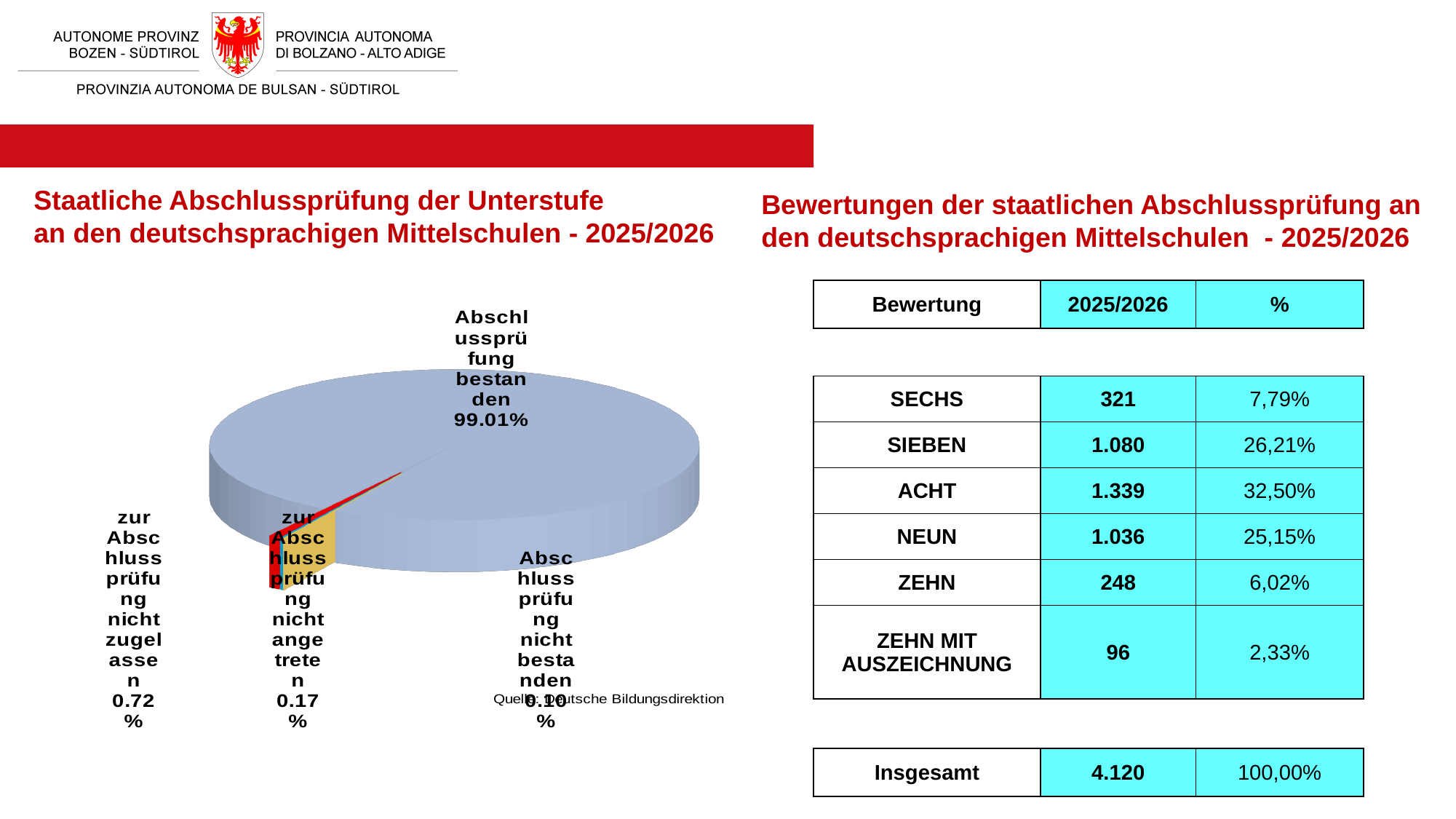
What is the title of the pie chart on the left of the slide? Staatliche Abschlussprüfung der Unterstufe an den deutschsprachigen Mittelschulen - 2025/2026 What is the difference in percentage points between "zur Abschlussprüfung nicht zugelassen" and "zur Abschlussprüfung nicht angetreten"? 0.55% What share of the pie is labelled "zur Abschlussprüfung nicht zugelassen"? 0.72% Which is larger in the pie chart: "zur Abschlussprüfung nicht angetreten" or "Abschlussprüfung nicht bestanden"? zur Abschlussprüfung nicht angetreten What share of the pie is labelled "Abschlussprüfung bestanden"? 99.01% Which slice of the pie chart is the smallest? Abschlussprüfung nicht bestanden What kind of chart is shown on the slide? pie chart How many slices does the pie chart have? 4 Which slice of the pie chart is the largest? Abschlussprüfung bestanden What source is cited below the pie chart? Quelle: Deutsche Bildungsdirektion What share of the pie is labelled "zur Abschlussprüfung nicht angetreten"? 0.17% What share of the pie is labelled "Abschlussprüfung nicht bestanden"? 0.10%